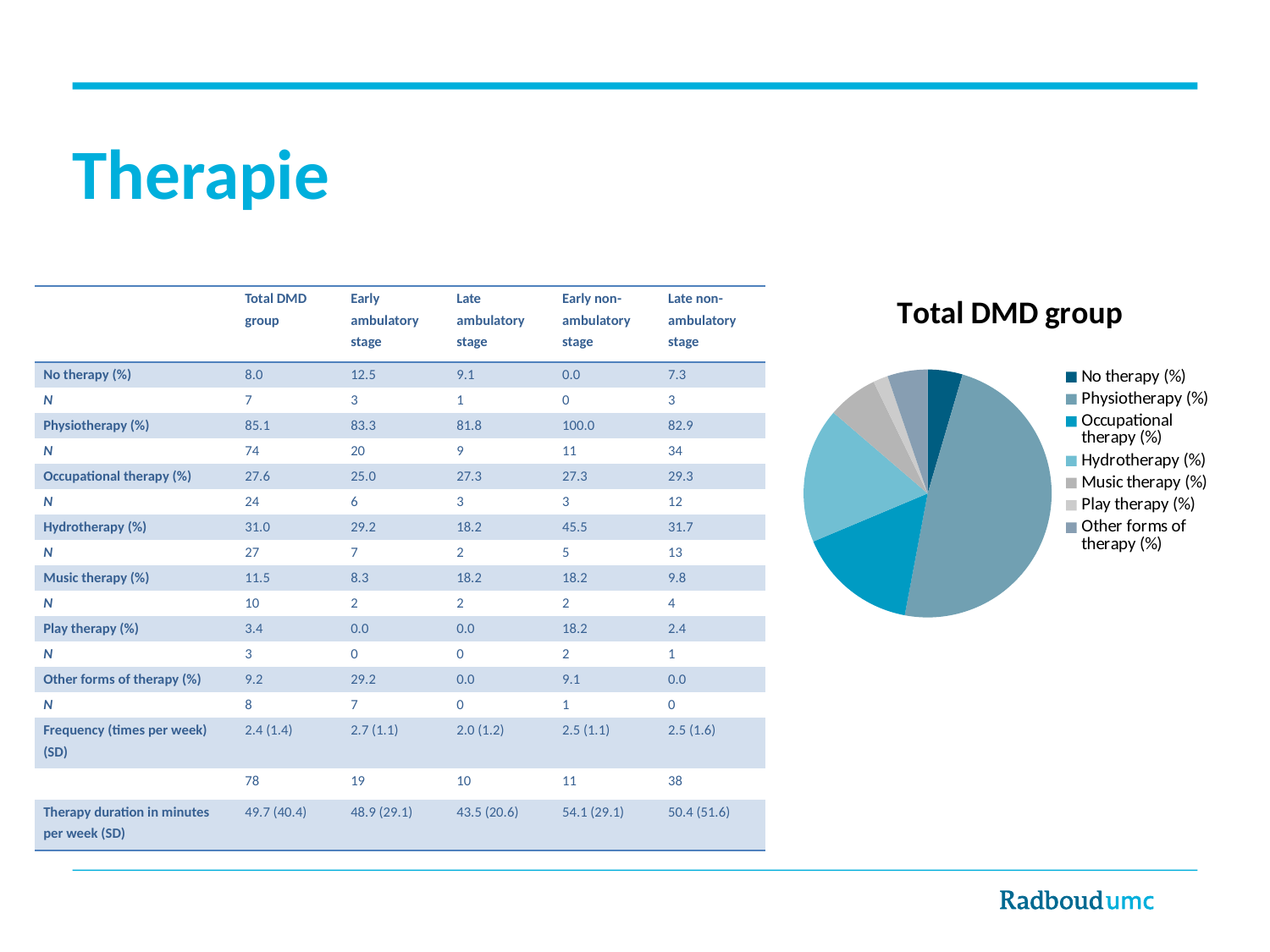
What kind of chart is shown on the slide? pie chart According to the table, what is the Physiotherapy (%) value for the Total DMD group plotted in the pie chart? 85.1 According to the table, what is the Play therapy (%) value for the Total DMD group plotted in the pie chart? 3.4 In the pie chart, which slice is larger: Hydrotherapy (%) or Music therapy (%)? Hydrotherapy (%) Which legend entry is listed first in the pie chart's legend? No therapy (%) In the pie chart, which slice is larger: No therapy (%) or Physiotherapy (%)? Physiotherapy (%) Which category has the smallest slice in the pie chart? Play therapy (%) In the pie chart, which slice is larger: Occupational therapy (%) or Play therapy (%)? Occupational therapy (%) According to the table, what is the Hydrotherapy (%) value for the Total DMD group plotted in the pie chart? 31.0 What is the title of the chart on the slide? Total DMD group Which category has the largest slice in the pie chart? Physiotherapy (%) How many categories does the legend of the pie chart list? 7